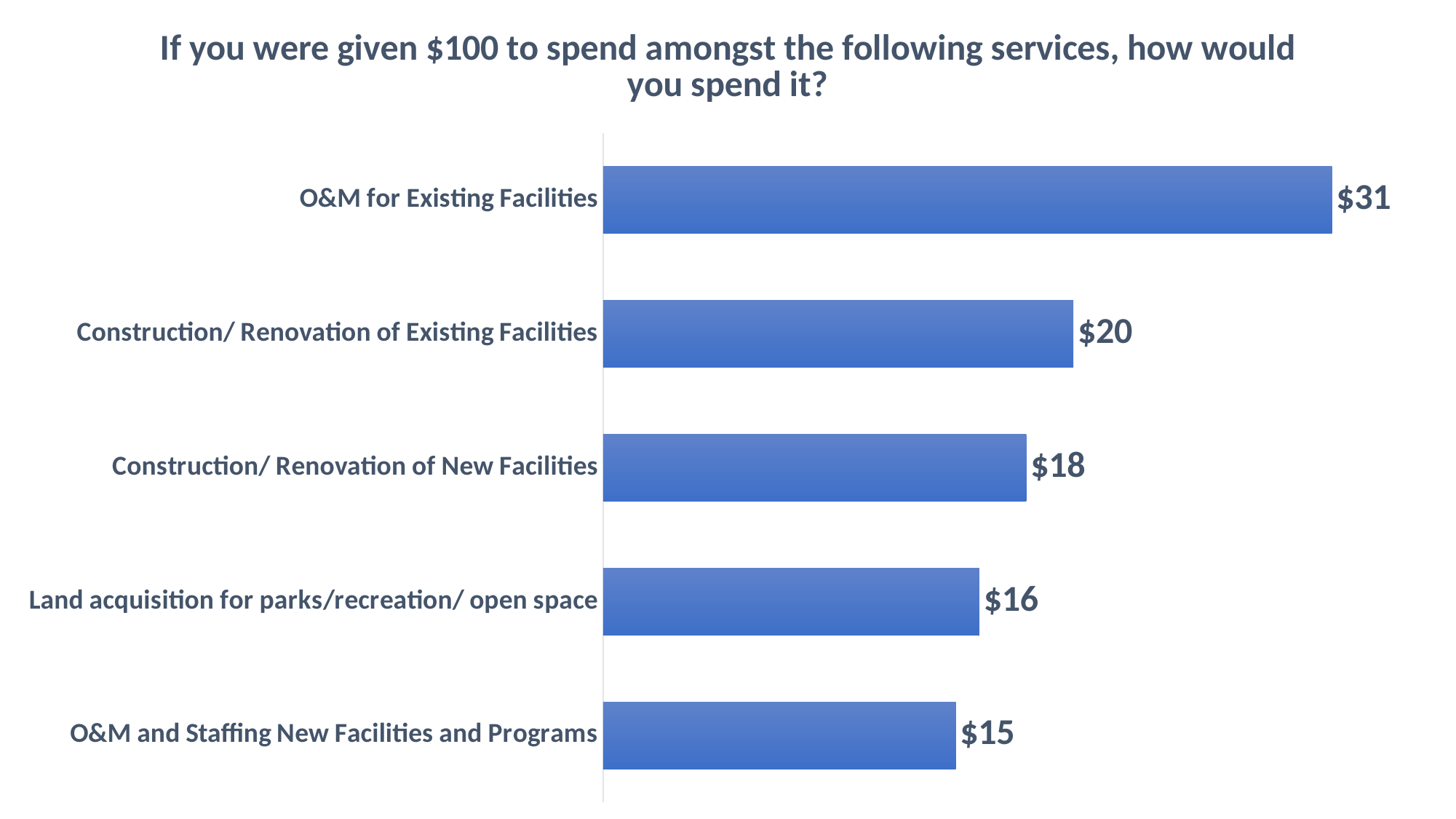
What is the value for O&M for Existing Facilities? $31 What kind of chart is shown on the slide? Bar chart Which category has the lowest value? O&M and Staffing New Facilities and Programs How many categories are shown in the chart? 5 Which category has the highest value? O&M for Existing Facilities What is the value for Land acquisition for parks/recreation/ open space? $16 What is the difference between the values for Construction/ Renovation of New Facilities and O&M and Staffing New Facilities and Programs? $3 What is the value for O&M and Staffing New Facilities and Programs? $15 What is the value for Construction/ Renovation of Existing Facilities? $20 What is the title of the chart? If you were given $100 to spend amongst the following services, how would you spend it? What is the difference between the values for O&M for Existing Facilities and Construction/ Renovation of Existing Facilities? $11 Which is larger: the value for Construction/ Renovation of New Facilities or the value for Land acquisition for parks/recreation/ open space? Construction/ Renovation of New Facilities